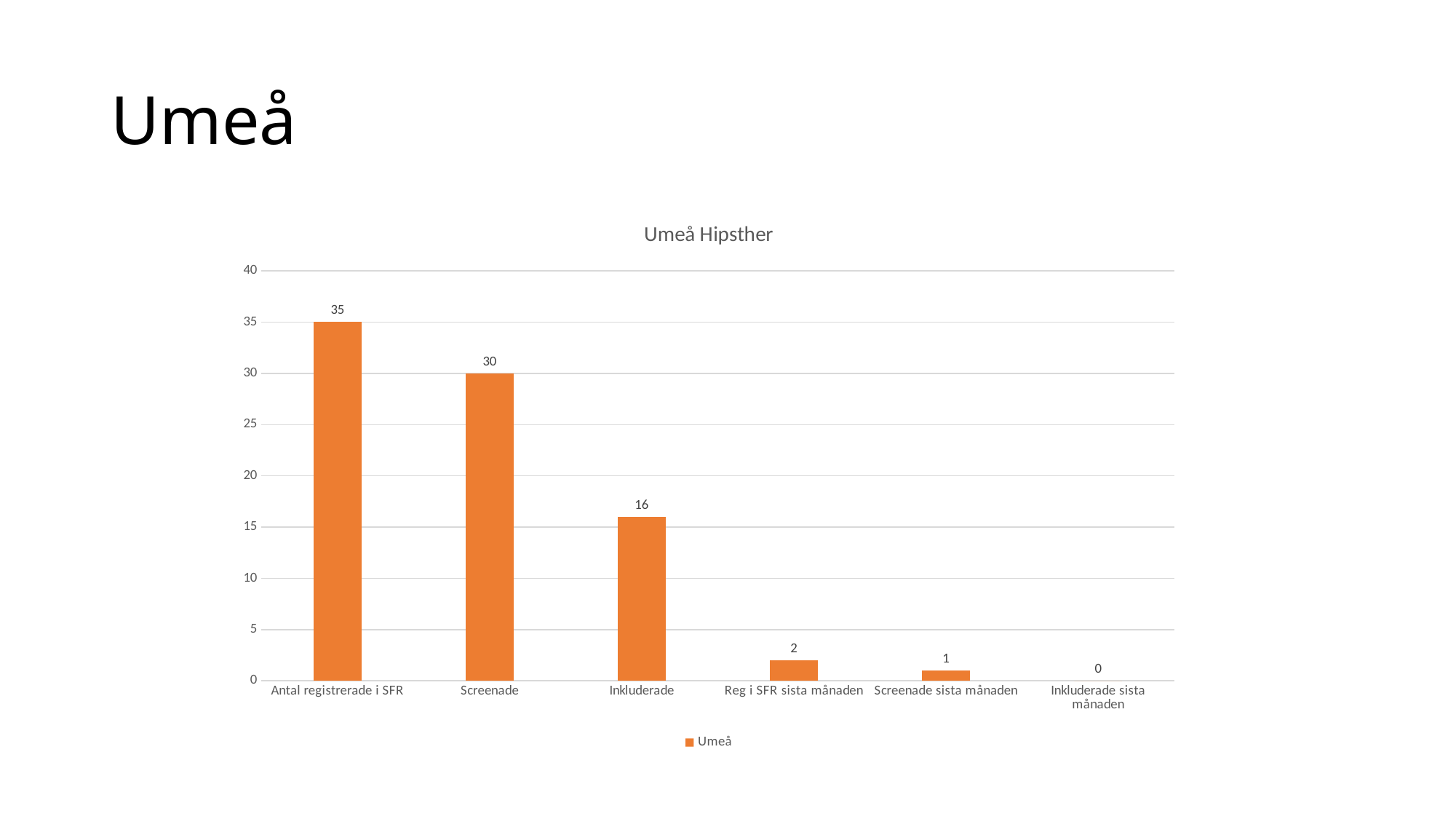
Which category has the lowest value? Inkluderade sista månaden What is the value for Inkluderade sista månaden? 0 Which category has the highest value? Antal registrerade i SFR What kind of chart is this? Bar chart How many categories are shown on the x axis? 6 What is the value for Antal registrerade i SFR? 35 What is the title of the chart? Umeå Hipsther What is the value for Reg i SFR sista månaden? 2 What is the value for Screenade? 30 What is the value for Inkluderade? 16 What is the difference between the values for Screenade and Inkluderade? 14 Which is larger, the value for Reg i SFR sista månaden or the value for Screenade sista månaden? Reg i SFR sista månaden